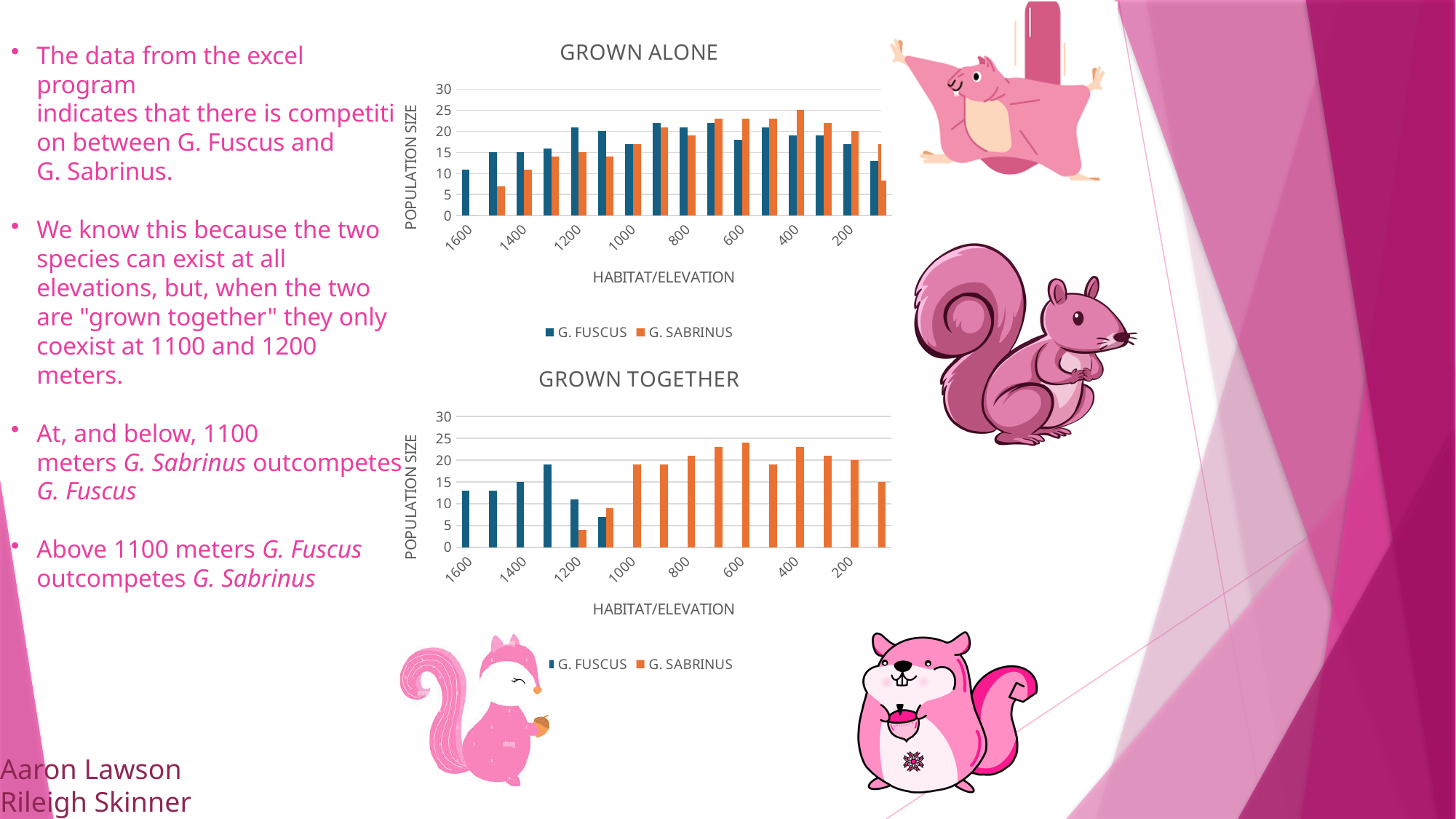
What type of chart is the GROWN ALONE chart? bar chart What is the title of the y axis on the GROWN ALONE chart? POPULATION SIZE In the GROWN TOGETHER chart, is the value for G. SABRINUS at 600 greater or less than 20? greater In the GROWN TOGETHER chart, which series has the tallest bar overall? G. SABRINUS In the GROWN ALONE chart, which series has the larger value at 1600, G. FUSCUS or G. SABRINUS? G. FUSCUS In the GROWN ALONE chart, is the value for G. SABRINUS at 1600 greater or less than 10? less In the GROWN ALONE chart, which series has the larger value at 400, G. FUSCUS or G. SABRINUS? G. SABRINUS In the GROWN ALONE chart, is the value for G. SABRINUS at 400 greater or less than 20? greater In the GROWN TOGETHER chart, which series has the larger value at 1200, G. FUSCUS or G. SABRINUS? G. FUSCUS How many series does the legend of the GROWN TOGETHER chart list? 2 What is the title of the x axis on the GROWN TOGETHER chart? HABITAT/ELEVATION